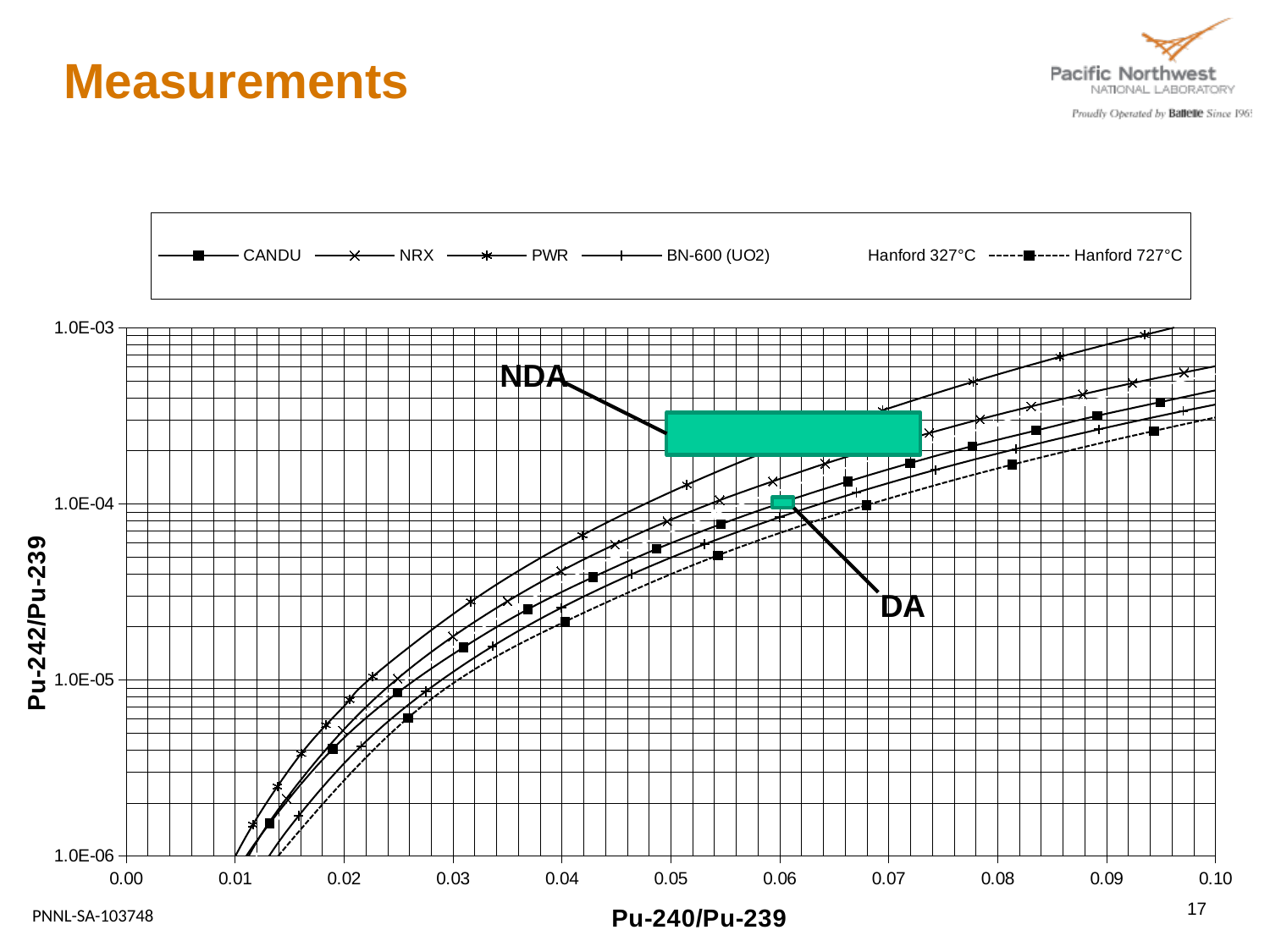
Is the Hanford 727°C value at Pu-240/Pu-239 = 0.02 greater or less than 1.0E-05? less What kind of chart is shown on the slide? line chart Do the plotted values rise or fall as Pu-240/Pu-239 increases? rise How many series does the legend list? 6 What is the title of the slide containing the chart? Measurements Which series has the highest Pu-242/Pu-239 values across the plotted range? PWR At Pu-240/Pu-239 = 0.08, which series has the larger Pu-242/Pu-239 value, PWR or Hanford 727°C? PWR Which series has the lowest Pu-242/Pu-239 values across the plotted range? Hanford 727°C Is the PWR value at Pu-240/Pu-239 = 0.09 greater or less than 1.0E-04? greater What is the label of the x axis? Pu-240/Pu-239 Is the CANDU value at Pu-240/Pu-239 = 0.03 greater or less than 1.0E-04? less What is the lowest value shown on the y axis? 1.0E-06